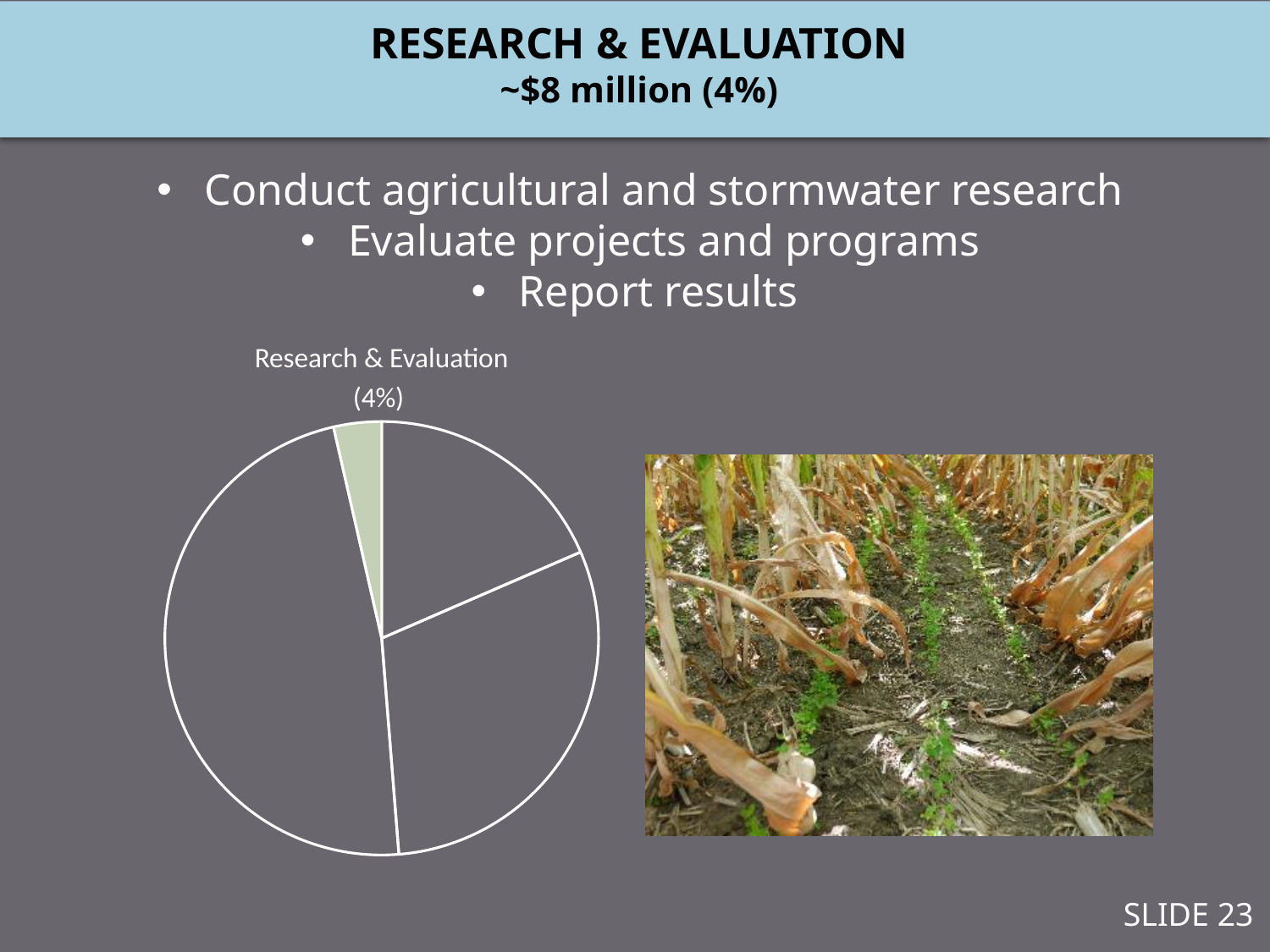
Is the Research & Evaluation slice larger or smaller than the large unlabelled slice on the left of the pie? smaller Which slice of the pie chart is the smallest? Research & Evaluation What share of the pie does the Research & Evaluation slice represent? 4% What colour is the Research & Evaluation slice in the pie chart? light green Which slice of the pie chart is labelled? Research & Evaluation (4%) How many slices does the pie chart have? 4 What kind of chart is shown on the slide? pie chart